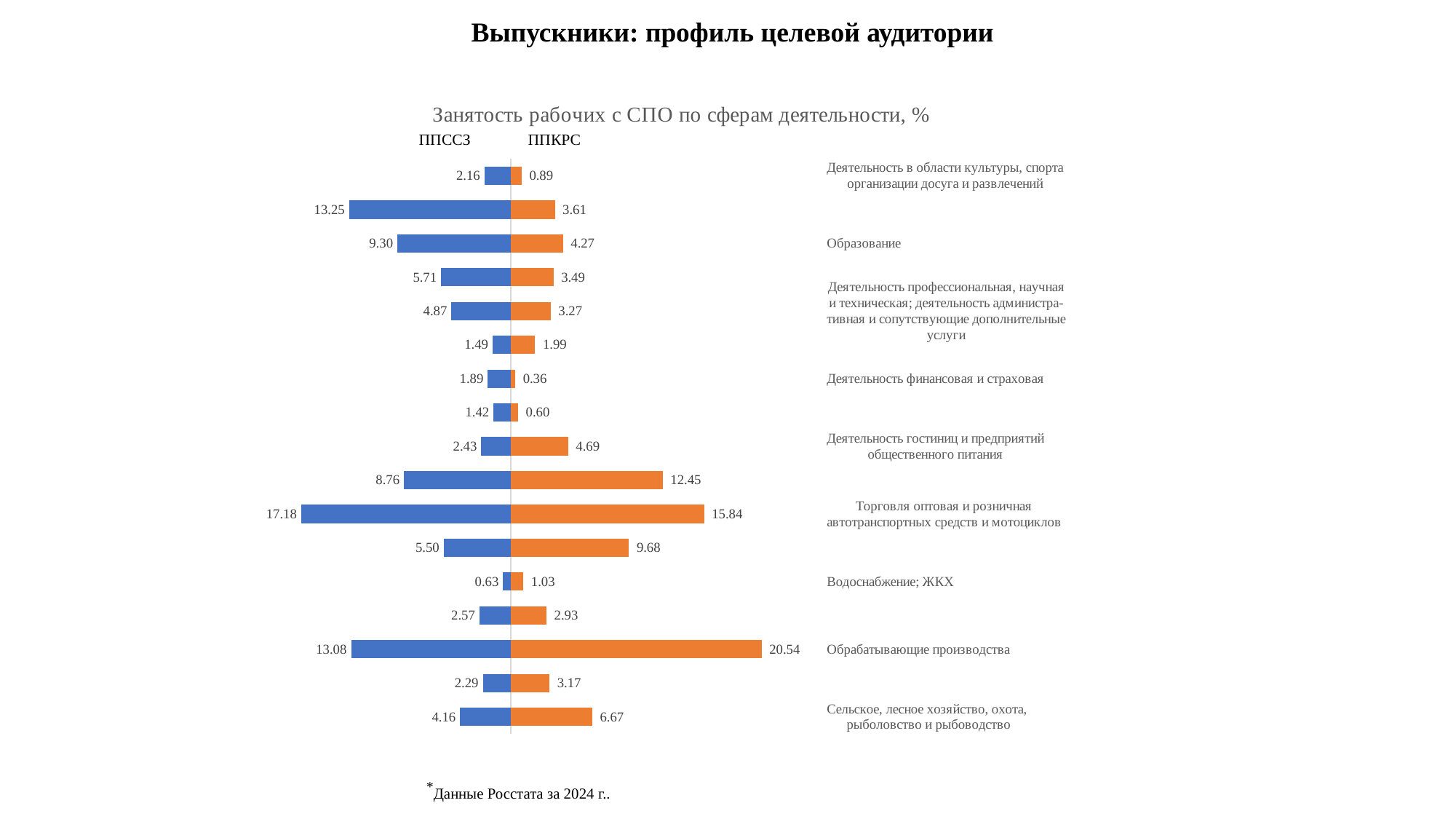
For Сельское, лесное хозяйство, охота, рыболовство и рыбоводство, which is larger: the ППССЗ value or the ППКРС value? ППКРС Which category has the highest ППКРС value? Обрабатывающие производства What is the ППССЗ value for Образование? 9.30 What is the ППССЗ value for Торговля оптовая и розничная автотранспортных средств и мотоциклов? 17.18 What type of chart is shown on the slide? Bar chart What is the title of the chart? Занятость рабочих с СПО по сферам деятельности, % How many series does the chart show? 2 What is the ППКРС value for Деятельность финансовая и страховая? 0.36 What is the ППКРС value for Обрабатывающие производства? 20.54 Which category has the lowest ППССЗ value? Водоснабжение; ЖКХ Which category has the highest ППССЗ value? Торговля оптовая и розничная автотранспортных средств и мотоциклов What is the difference between the ППКРС and ППССЗ values for Обрабатывающие производства? 7.46